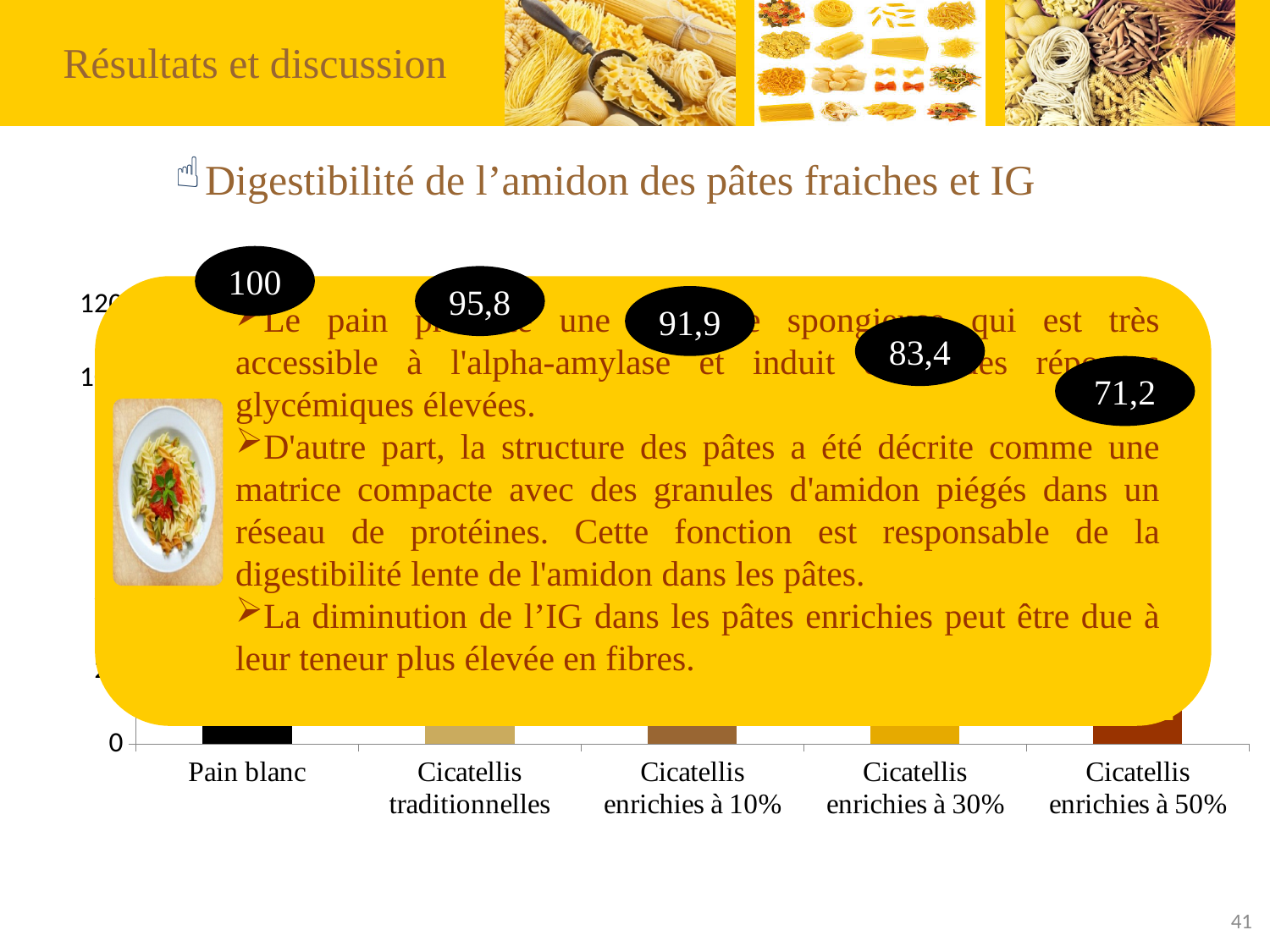
What value is shown for Cicatellis traditionnelles? 95,8 What value is shown for Cicatellis enrichies à 30%? 83,4 What kind of chart is shown on the slide? Bar chart What value is shown for Cicatellis enrichies à 10%? 91,9 How many categories are shown on the x axis of the chart? 5 Which category has the highest value? Pain blanc What value is shown for Pain blanc? 100 Which is larger: the value for Cicatellis enrichies à 10% or Cicatellis enrichies à 30%? Cicatellis enrichies à 10% What value is shown for Cicatellis enrichies à 50%? 71,2 Which category has the lowest value? Cicatellis enrichies à 50% What is the difference between the values for Pain blanc and Cicatellis enrichies à 50%? 28,8 Do the values rise or fall from left to right along the x axis? Fall